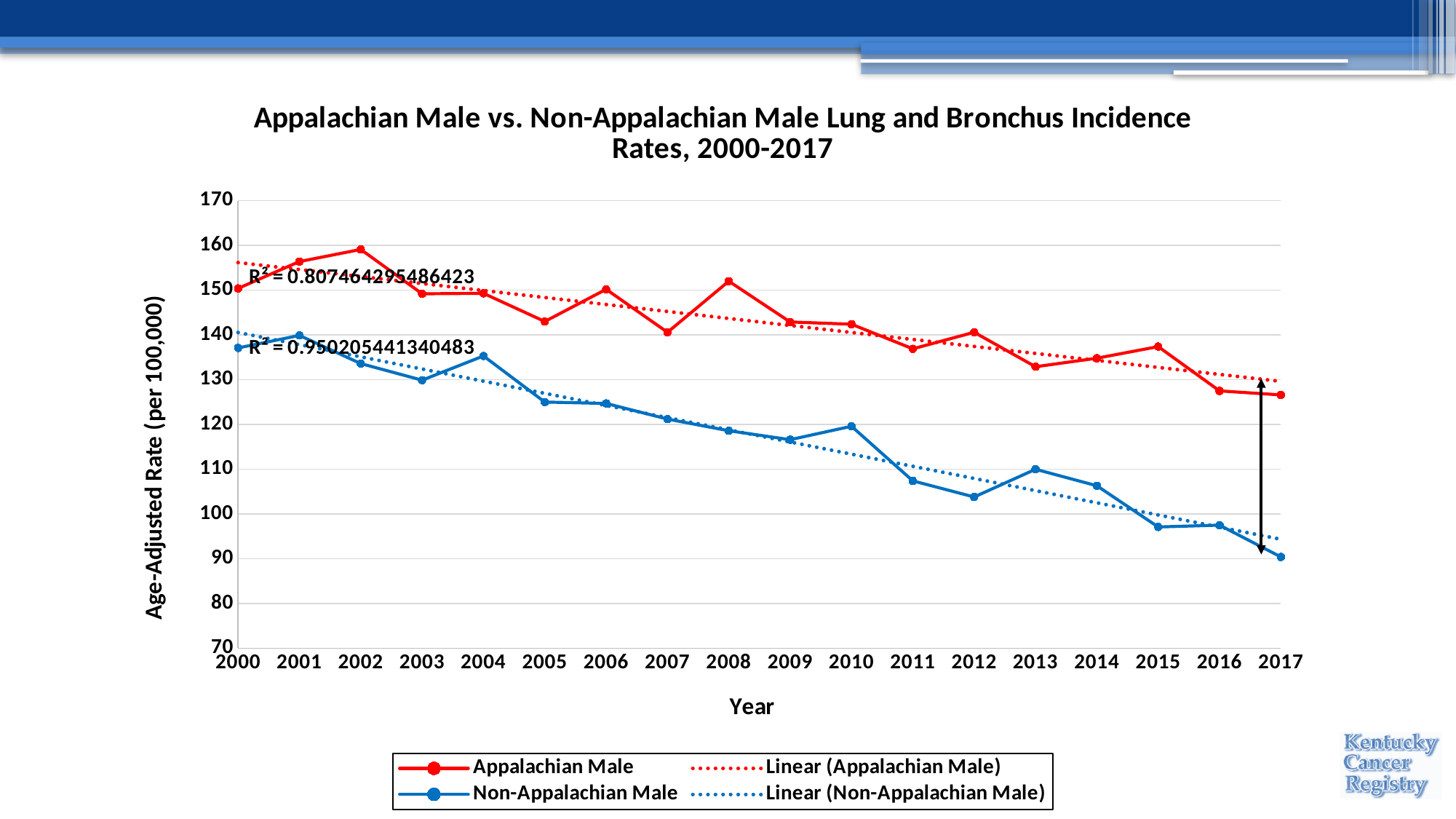
Is the Appalachian Male value for 2002 greater or less than 150? greater What is the R² value shown for the Non-Appalachian Male trendline? 0.950205441340483 In which year is the Appalachian Male rate highest? 2002 What kind of chart is shown on the slide? line chart Is the Appalachian Male value for 2017 greater or less than 130? less How many years are plotted along the x axis? 18 In which year is the Non-Appalachian Male rate lowest? 2017 In 2010, which series has the larger value, Appalachian Male or Non-Appalachian Male? Appalachian Male Is the Non-Appalachian Male value for 2017 greater or less than 100? less How many entries does the legend list? 4 Do the Non-Appalachian Male rates generally rise or fall from 2000 to 2017? fall